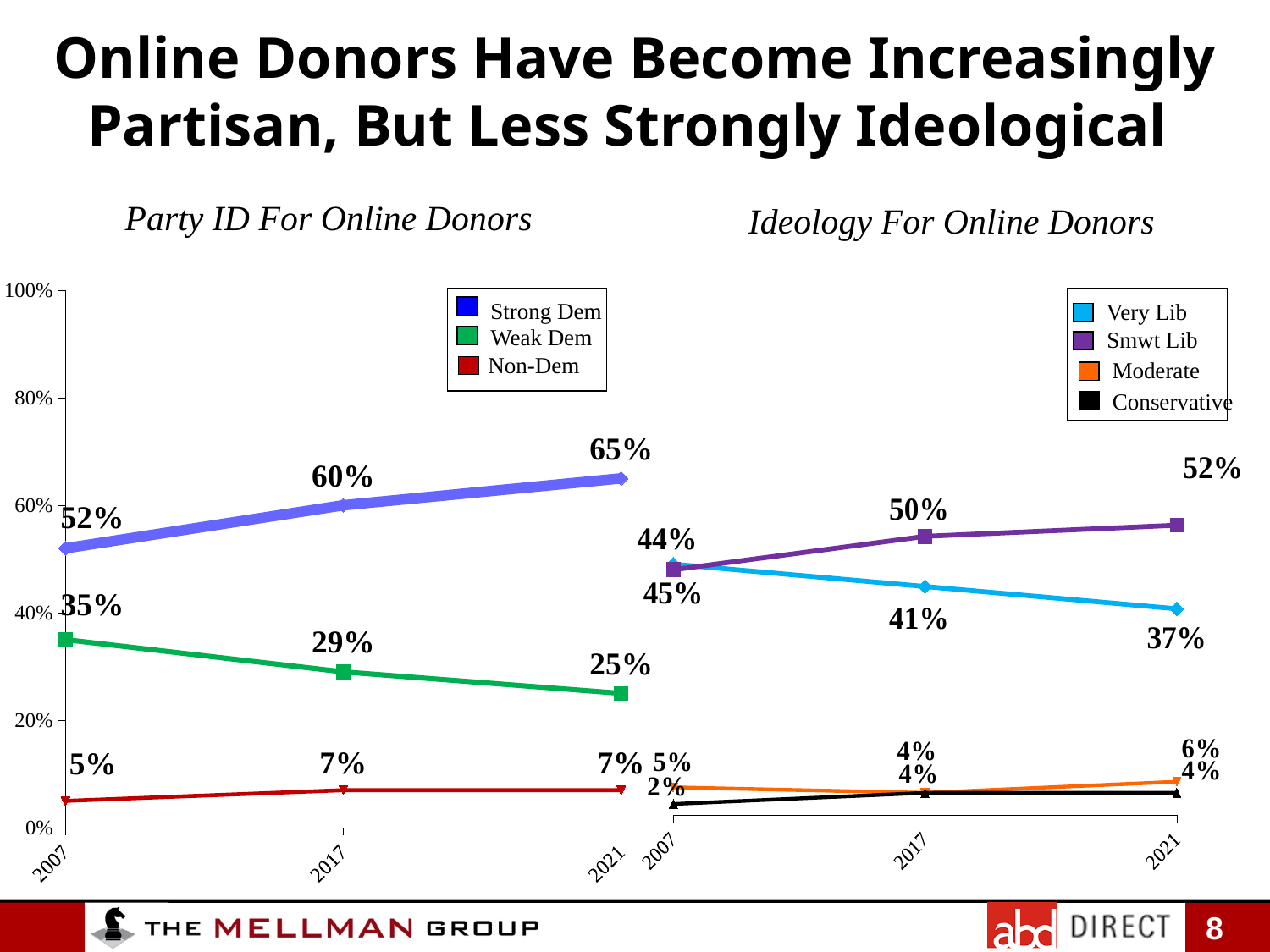
In the Ideology For Online Donors chart, what is the difference between Smwt Lib and Very Lib in 2021? 15 percentage points In the Ideology For Online Donors chart, what is the value for Smwt Lib in 2021? 52% In the Ideology For Online Donors chart, what is the value for Moderate in 2021? 6% What type of chart is the Ideology For Online Donors chart? line chart In the Ideology For Online Donors chart, which is larger in 2021, Smwt Lib or Very Lib? Smwt Lib In the Party ID For Online Donors chart, what is the value for Non-Dem in 2017? 7% In the Party ID For Online Donors chart, does the Weak Dem line rise or fall from 2007 to 2021? fall In the Ideology For Online Donors chart, what is the value for Very Lib in 2017? 41% In the Party ID For Online Donors chart, how many series does the legend list? 3 In the Party ID For Online Donors chart, what is the value for Strong Dem in 2021? 65% In the Party ID For Online Donors chart, what is the value for Weak Dem in 2007? 35% In the Party ID For Online Donors chart, by how many percentage points did Strong Dem change from 2007 to 2021? 13 percentage points